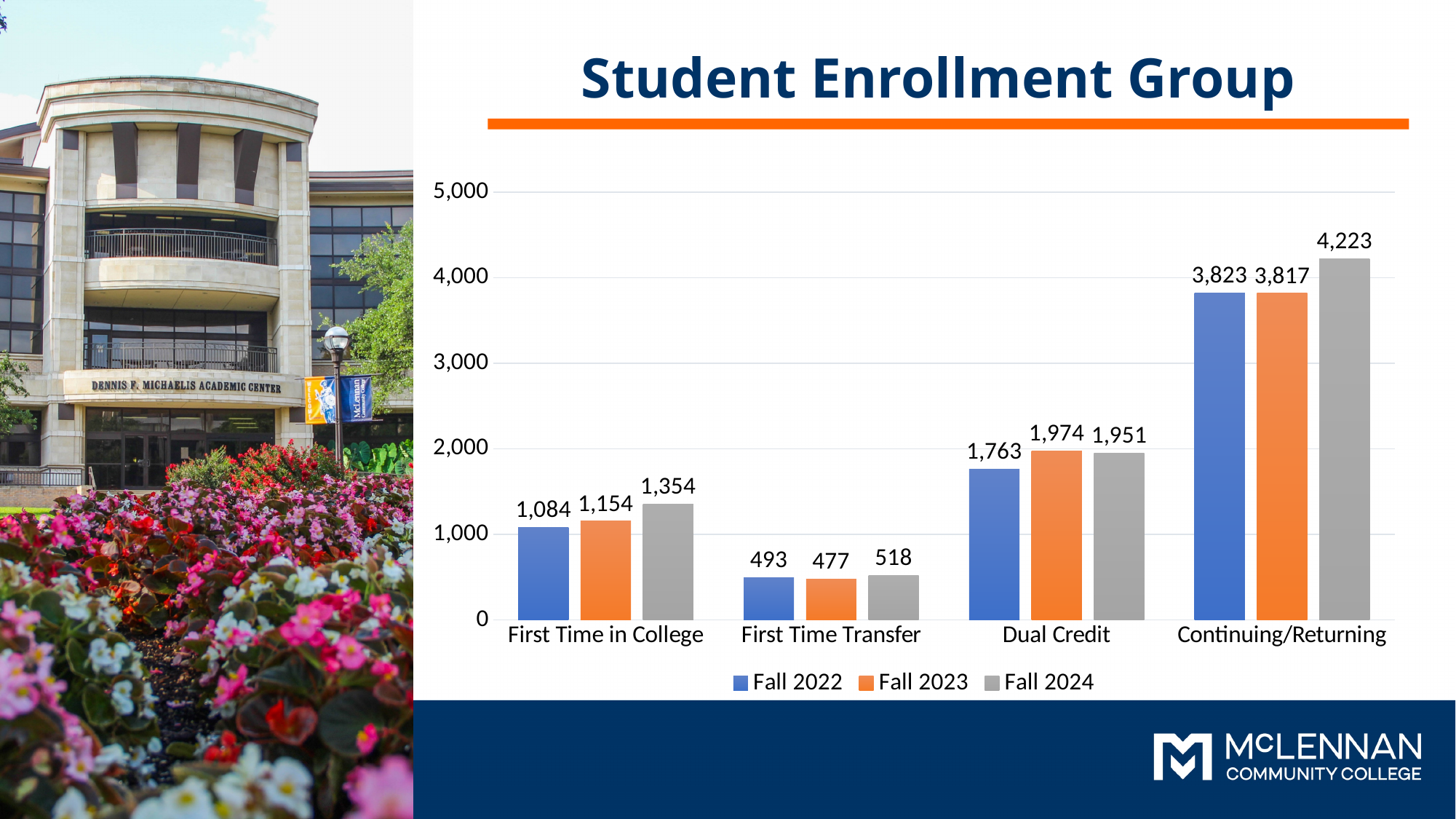
Which is larger for Dual Credit: the Fall 2023 value or the Fall 2024 value? Fall 2023 How many categories are shown on the x axis? 4 Which category has the lowest Fall 2022 value? First Time Transfer What kind of chart is shown on the slide? Bar chart What is the difference between the Fall 2024 and Fall 2022 values for First Time in College? 270 Which category has the highest Fall 2024 value? Continuing/Returning What is the Fall 2023 value for Dual Credit? 1,974 What is the title of the chart? Student Enrollment Group What is the Fall 2022 value for First Time Transfer? 493 What is the Fall 2024 value for Continuing/Returning? 4,223 Do the First Time in College values rise or fall from Fall 2022 to Fall 2024? Rise How many series does the legend list? 3